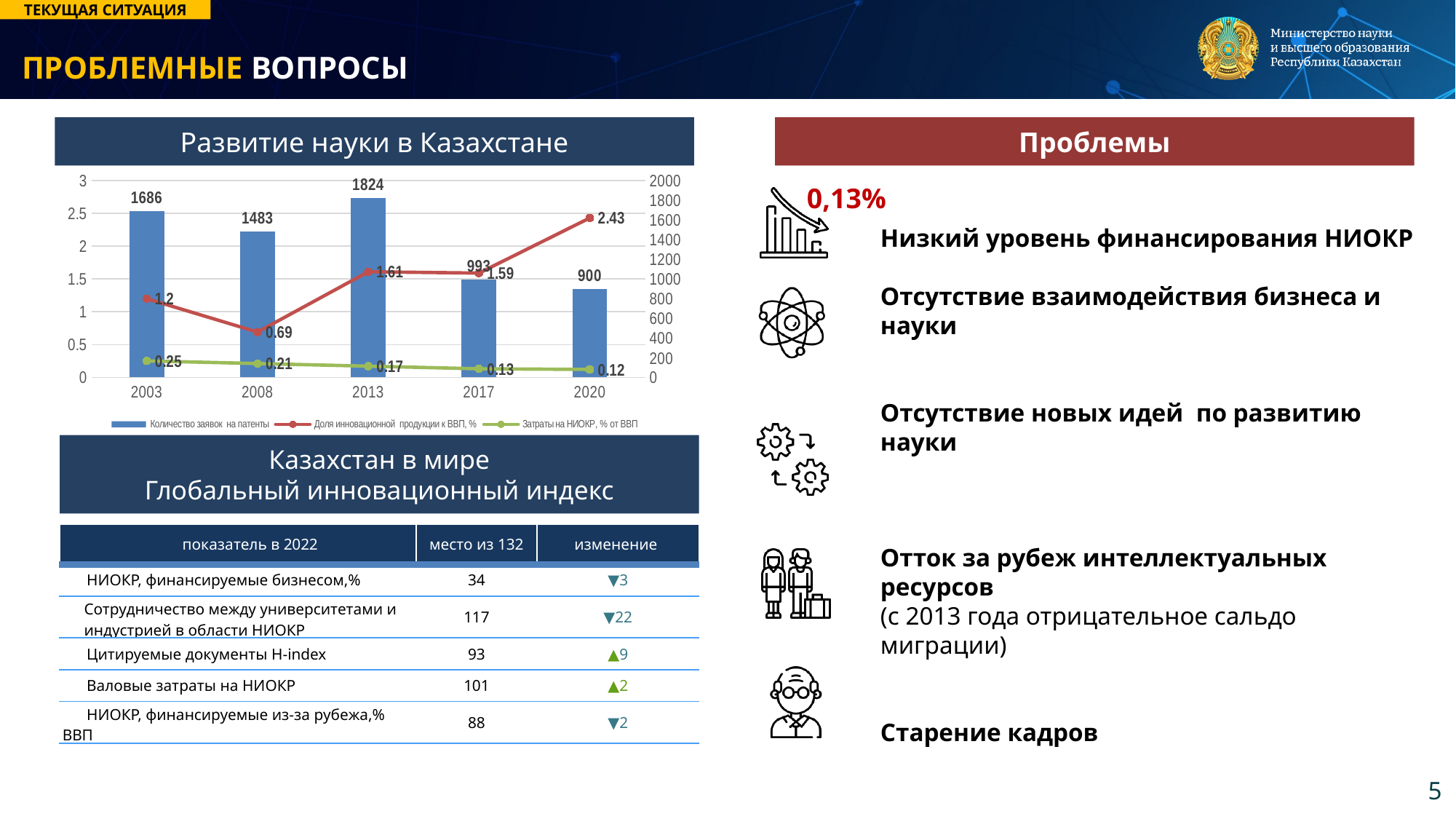
How many series does the legend of the chart 'Развитие науки в Казахстане' list? 3 What kind of chart is 'Развитие науки в Казахстане'? Combined bar and line chart In the chart 'Развитие науки в Казахстане', what colour are the bars for 'Количество заявок на патенты'? Blue In the chart 'Развитие науки в Казахстане', which year has the highest value of 'Доля инновационной продукции к ВВП, %'? 2020 In the chart 'Развитие науки в Казахстане', which year has more patent applications, 2003 or 2008? 2003 In the chart 'Развитие науки в Казахстане', what is the number of patent applications (Количество заявок на патенты) in 2013? 1824 In the chart 'Развитие науки в Казахстане', how many years are shown on the x axis? 5 In the chart 'Развитие науки в Казахстане', what is the difference in patent applications between 2013 and 2017? 831 In the chart 'Развитие науки в Казахстане', what is the value of 'Доля инновационной продукции к ВВП, %' in 2020? 2.43 In the chart 'Развитие науки в Казахстане', which year has the lowest number of patent applications? 2020 In the chart 'Развитие науки в Казахстане', what is the value of 'Затраты на НИОКР, % от ВВП' in 2003? 0.25 In the chart 'Развитие науки в Казахстане', does 'Затраты на НИОКР, % от ВВП' rise or fall from 2003 to 2020? Fall